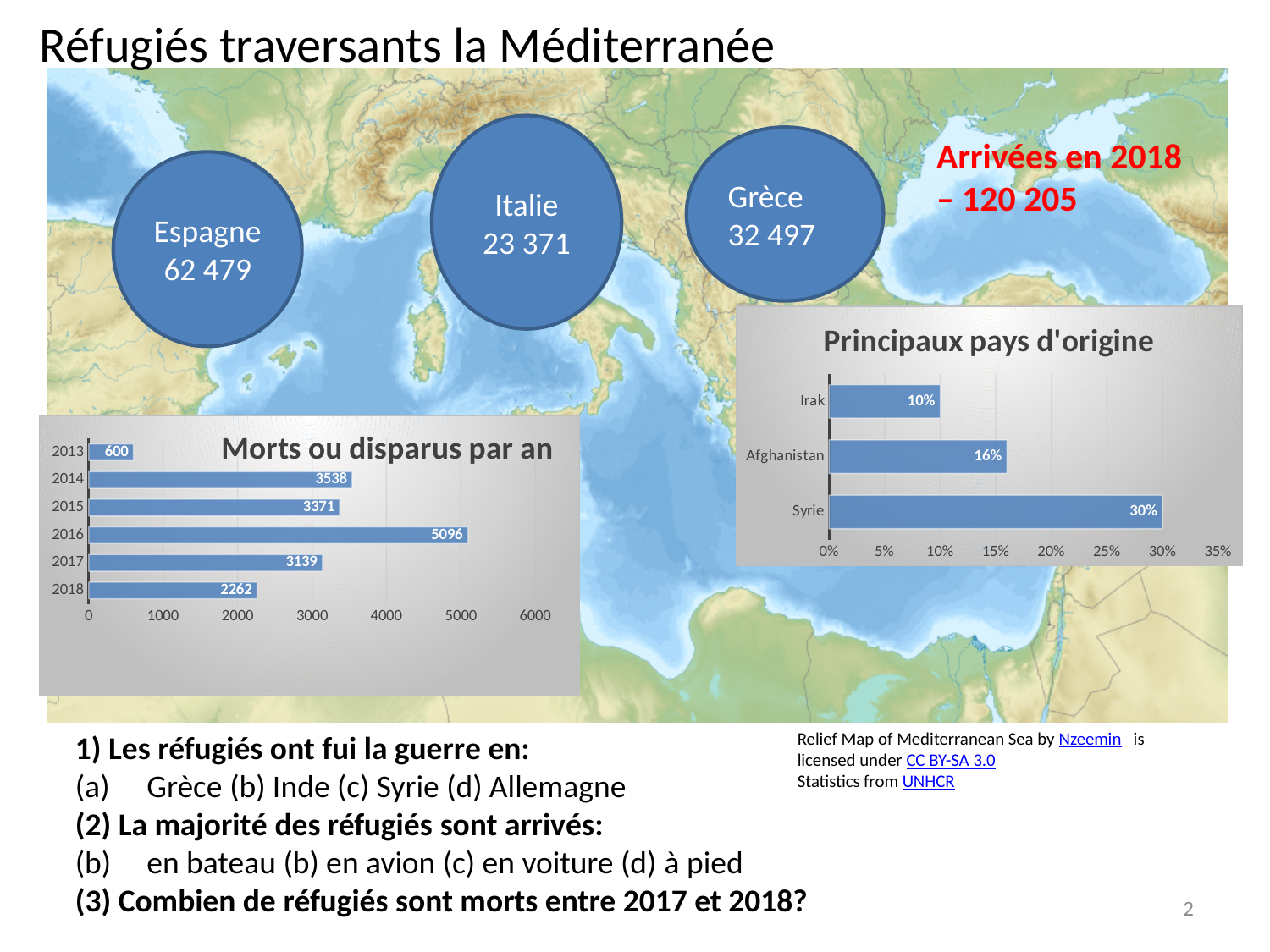
In the 'Morts ou disparus par an' chart, what is the difference between the values for 2017 and 2018? 877 What kind of chart is 'Morts ou disparus par an'? Bar chart In the 'Morts ou disparus par an' chart, what is the value for 2018? 2262 In the 'Morts ou disparus par an' chart, which is larger, the value for 2014 or the value for 2015? 2014 In the 'Morts ou disparus par an' chart, what is the value for 2016? 5096 In the 'Morts ou disparus par an' chart, which year has the highest value? 2016 How many countries are shown in the 'Principaux pays d'origine' chart? 3 In the 'Morts ou disparus par an' chart, which year has the lowest value? 2013 In the 'Principaux pays d'origine' chart, what is the difference between the values for Syrie and Irak? 20% How many years are shown in the 'Morts ou disparus par an' chart? 6 In the 'Principaux pays d'origine' chart, which country has the highest value? Syrie In the 'Principaux pays d'origine' chart, what is the value for Afghanistan? 16%